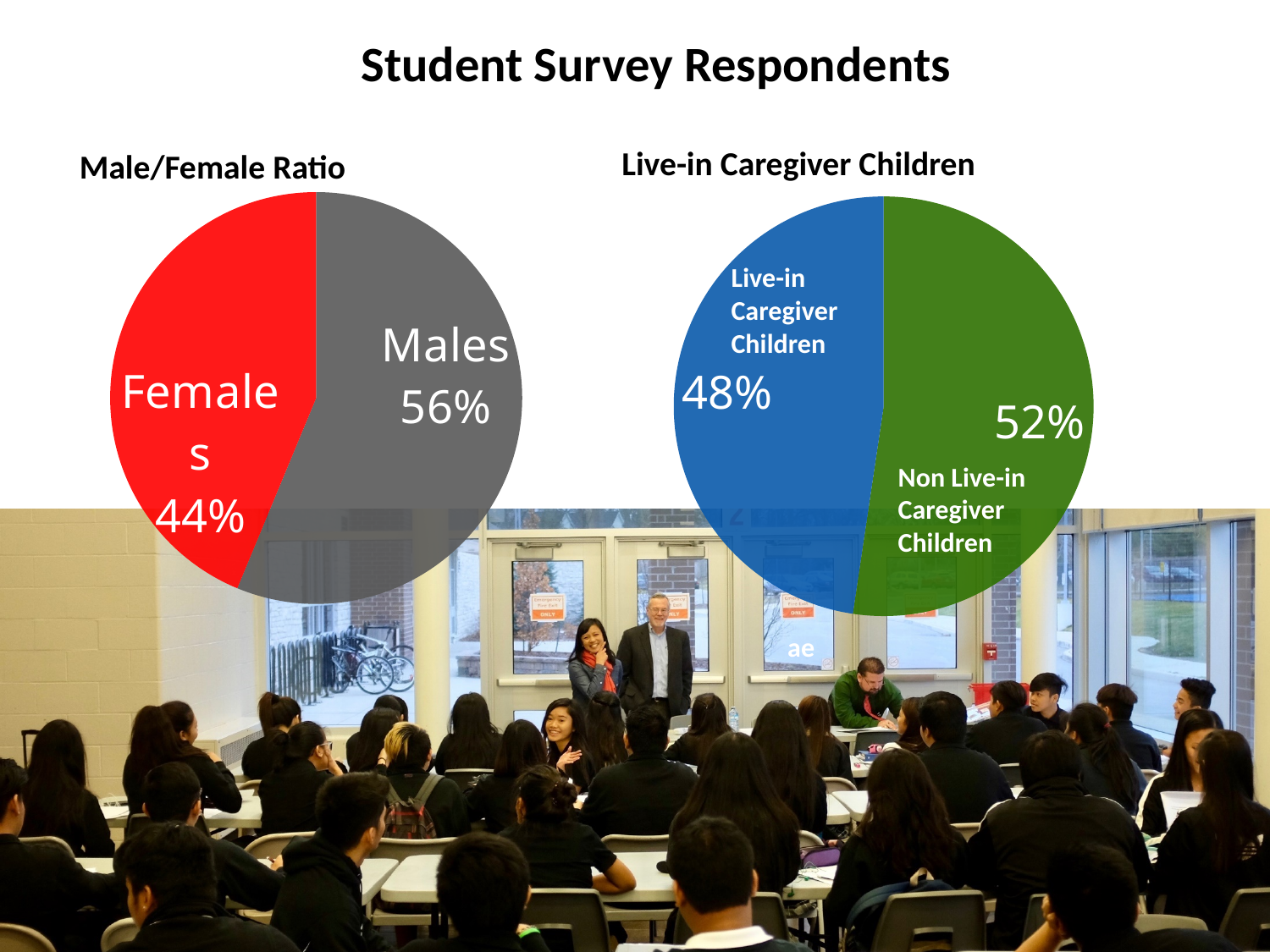
In the Male/Female Ratio chart, what percentage of respondents are Males? 56% How many slices does the Live-in Caregiver Children chart have? 2 In the Live-in Caregiver Children chart, what share is Non Live-in Caregiver Children? 52% In the Male/Female Ratio chart, what percentage of respondents are Females? 44% What type of chart is the Male/Female Ratio chart? Pie chart In the Male/Female Ratio chart, what is the difference in percentage points between Males and Females? 12 In the Live-in Caregiver Children chart, what is the difference in percentage points between Non Live-in Caregiver Children and Live-in Caregiver Children? 4 In the Male/Female Ratio chart, which group is larger, Males or Females? Males In the Male/Female Ratio chart, what colour is the Females slice? Red In the Live-in Caregiver Children chart, which slice is the smallest? Live-in Caregiver Children In the Live-in Caregiver Children chart, which slice is the largest? Non Live-in Caregiver Children In the Live-in Caregiver Children chart, what share is Live-in Caregiver Children? 48%